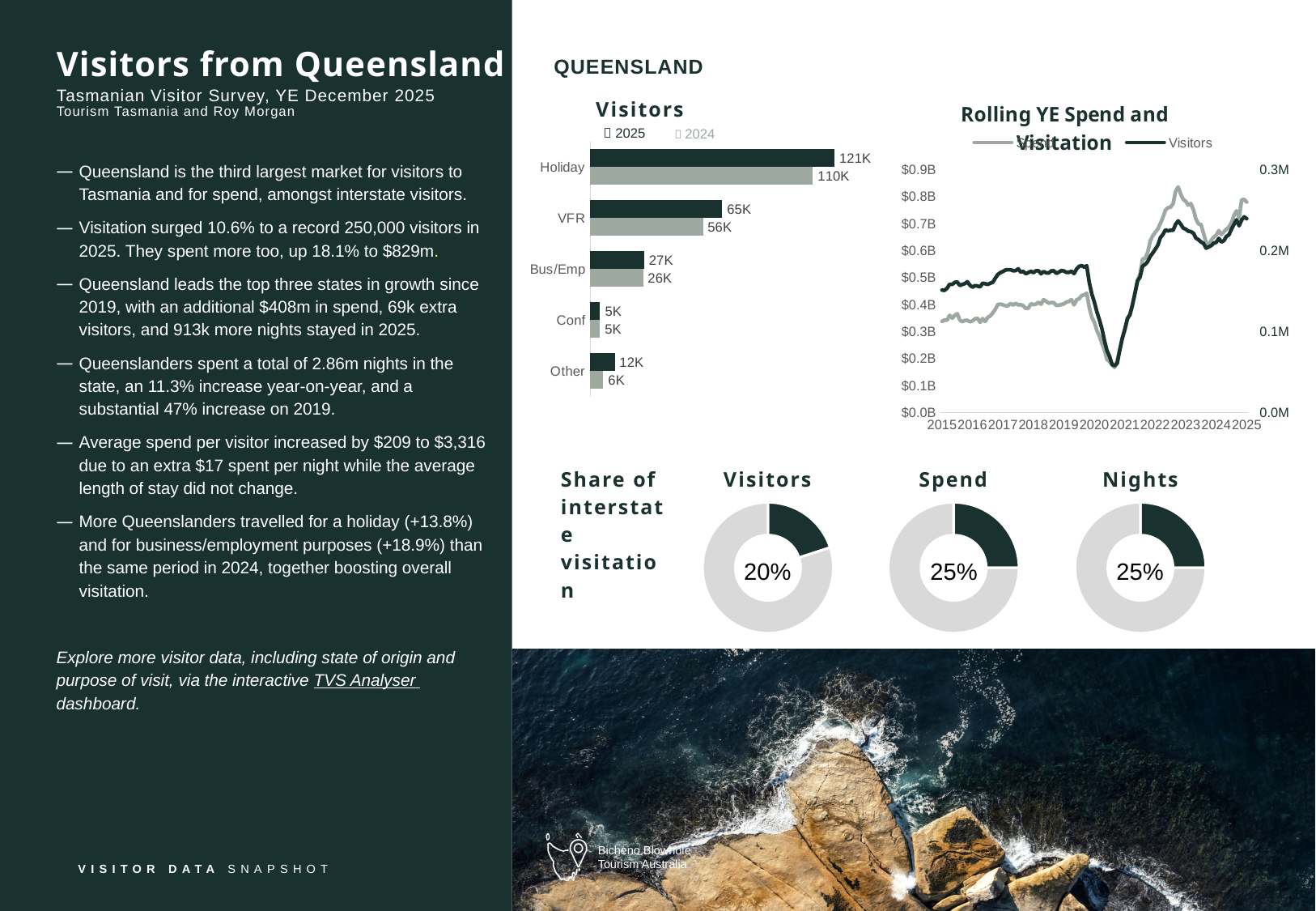
In the Visitors bar chart, which is larger for Other: the 2025 value or the 2024 value? 2025 How many series does the legend of the Visitors bar chart list? 2 In the Visitors bar chart, what is the 2025 value for Holiday? 121K What kind of chart is the Rolling YE Spend and Visitation chart? Line chart In the Share of interstate visitation donut charts, what share is shown for Visitors? 20% In the Visitors bar chart, which category has the highest 2025 value? Holiday In the Visitors bar chart, what is the difference between the 2025 and 2024 values for Holiday? 11K In the Visitors bar chart, what is the 2024 value for VFR? 56K In the Visitors bar chart, which category has the lowest 2025 value? Conf In the Rolling YE Spend and Visitation chart, is the Spend value at the end of 2025 greater or less than $0.6B? greater How many categories are shown in the Visitors bar chart? 5 In the Visitors bar chart, what is the 2025 value for Bus/Emp? 27K